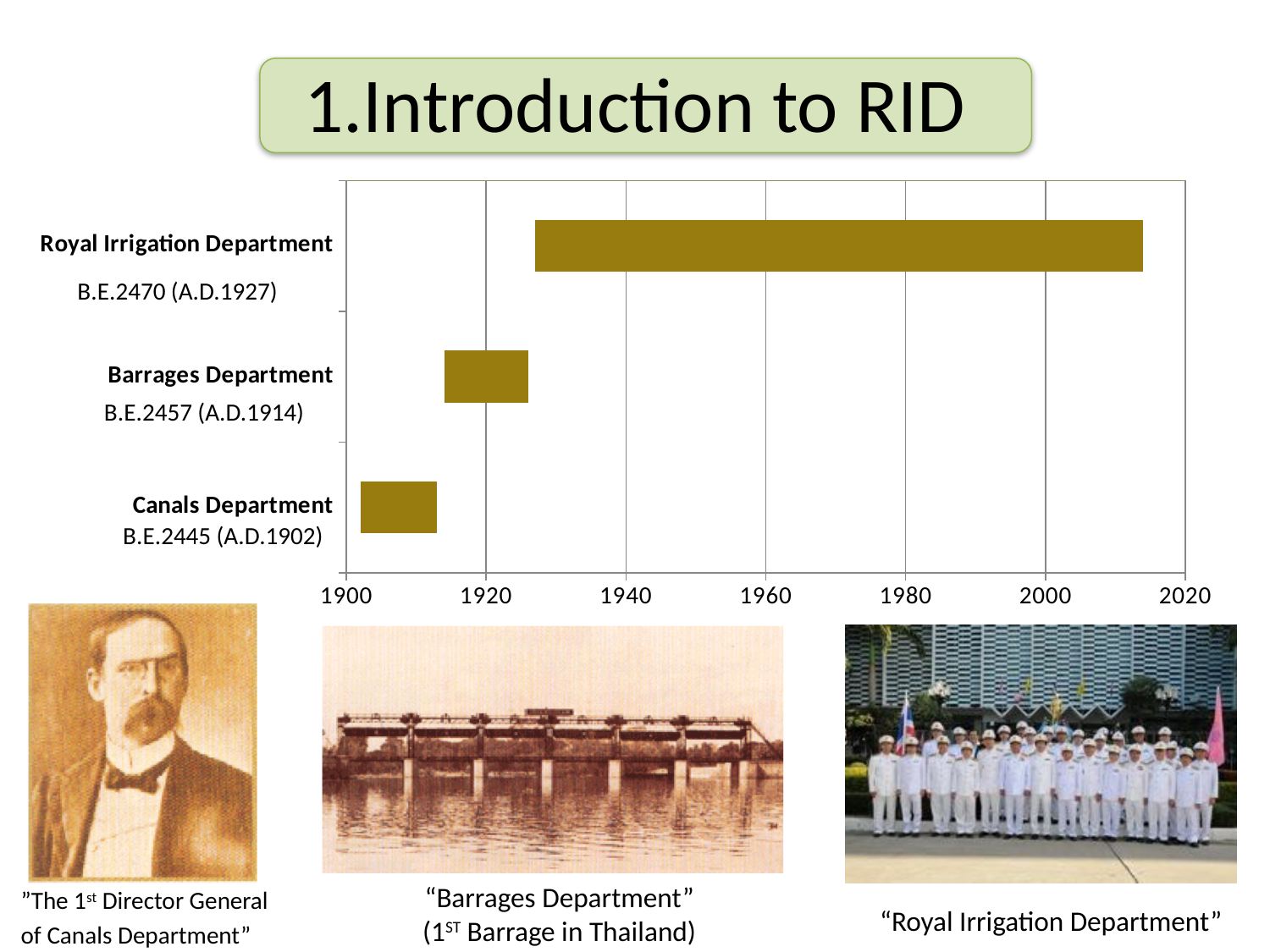
What kind of chart is shown on the slide? bar chart What is the B.E. year given for the Royal Irrigation Department? B.E.2470 What are the first and last year labels shown on the horizontal axis? 1900 and 2020 Does the bar for the Royal Irrigation Department extend past the year 2000 on the axis? Yes How many years passed between the founding of the Canals Department (A.D.1902) and the Barrages Department (A.D.1914)? 12 How many departments are plotted in the chart? 3 Which department has the longest bar in the chart? Royal Irrigation Department In which A.D. year was the Royal Irrigation Department established, according to the chart label? 1927 How many years passed between the founding of the Canals Department (A.D.1902) and the Royal Irrigation Department (A.D.1927)? 25 In which A.D. year was the Barrages Department established, according to the chart label? 1914 Does the bar for the Barrages Department end before or after 1940 on the axis? before In which A.D. year was the Canals Department established, according to the chart label? 1902